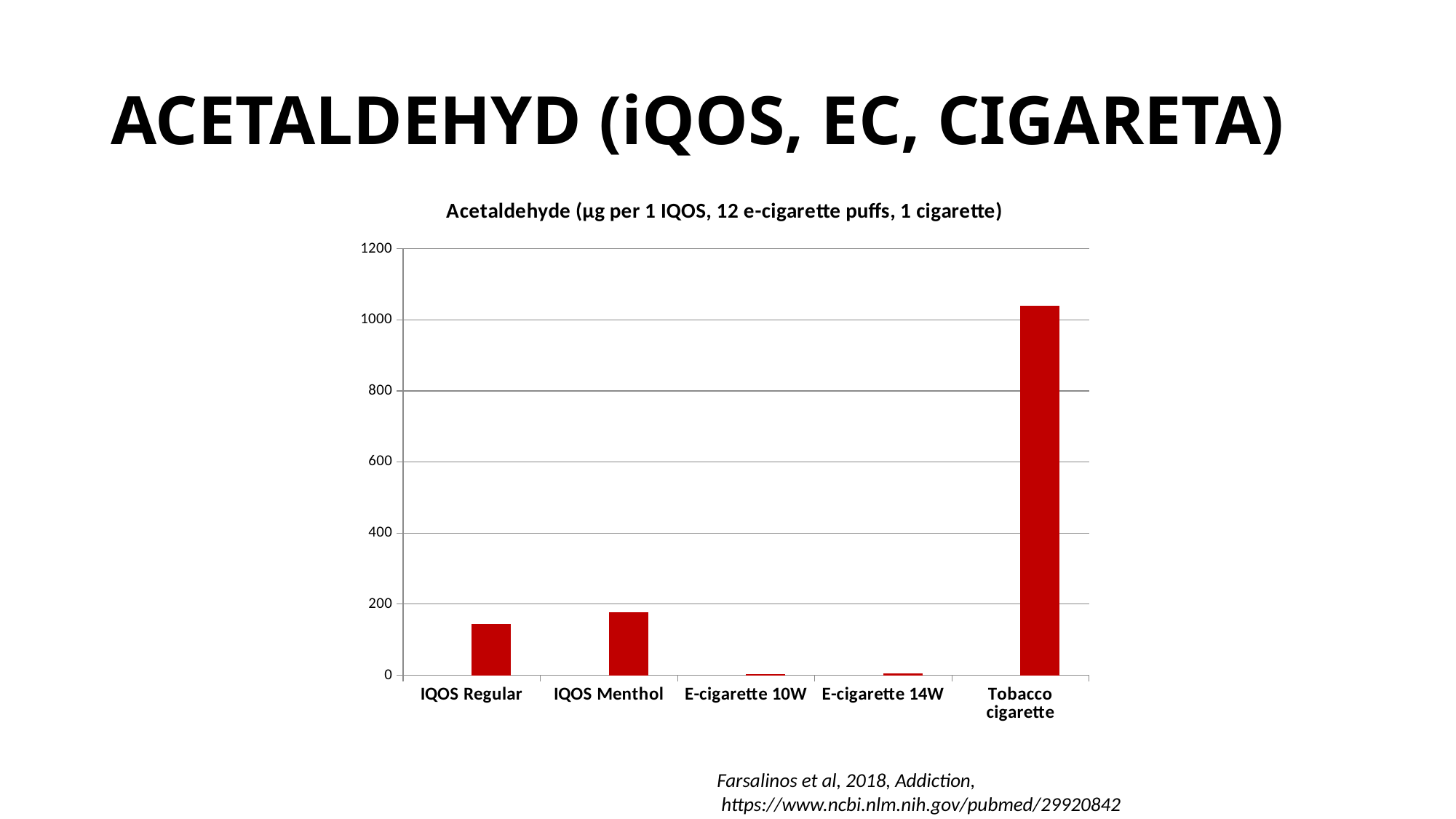
Which is larger, the value for IQOS Menthol or the value for IQOS Regular? IQOS Menthol Is the value for IQOS Regular greater or less than 200? less How many categories are shown on the x axis of the chart? 5 Is the value for IQOS Menthol greater or less than 200? less Which category has the highest acetaldehyde value? Tobacco cigarette Which is larger, the value for Tobacco cigarette or the value for IQOS Menthol? Tobacco cigarette Is the value for E-cigarette 14W greater or less than 200? less What is the title of the chart? Acetaldehyde (µg per 1 IQOS, 12 e-cigarette puffs, 1 cigarette) Which is larger, the value for IQOS Regular or the value for E-cigarette 10W? IQOS Regular What is the highest value shown on the y axis of the chart? 1200 What kind of chart is shown on the slide? bar chart